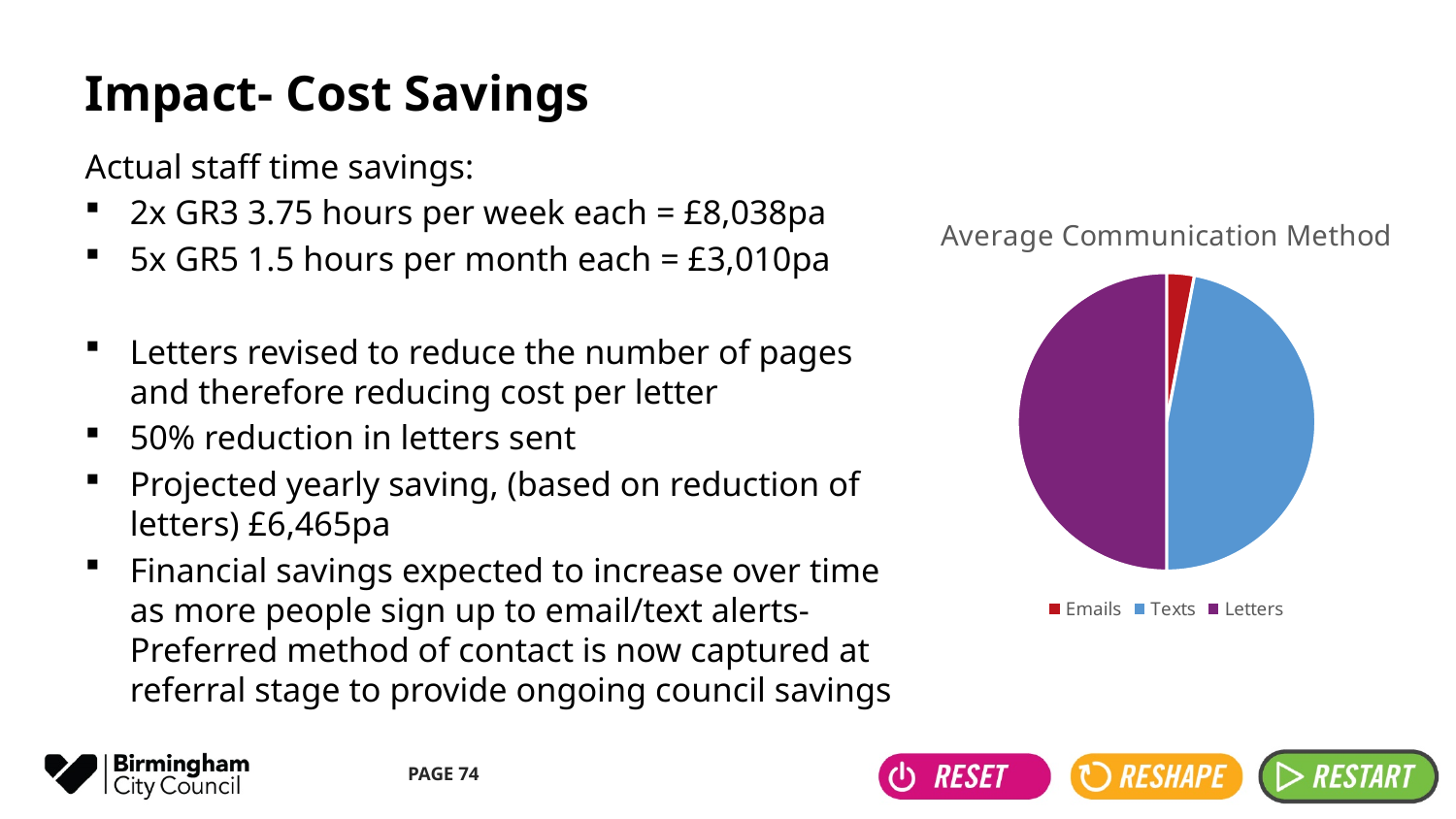
How many categories does the pie chart show? 3 How many entries does the chart legend list? 3 Which colour represents Letters in the pie chart? purple Which communication method has the smallest slice of the pie? Emails What kind of chart is shown on the slide? pie chart Which slice is larger, Letters or Emails? Letters What is the title of the chart? Average Communication Method Which slice is larger, Emails or Texts? Texts